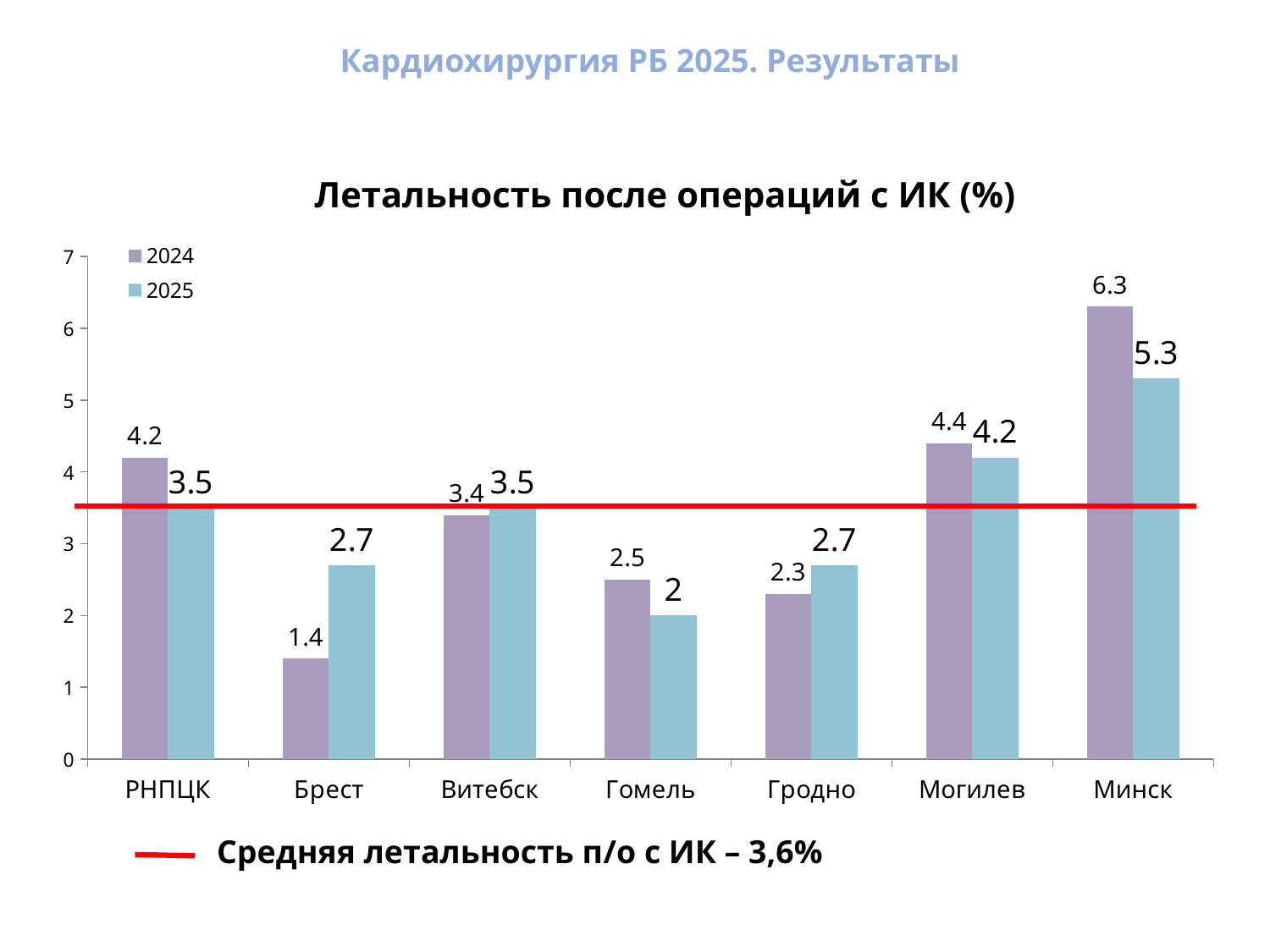
How many series does the legend list? 2 What is the title of the chart? Летальность после операций с ИК (%) Which category has the highest 2024 value? Минск Which category has the lowest 2025 value? Гомель Which is larger for Гродно, the 2024 value or the 2025 value? 2025 What kind of chart is shown on the slide? bar chart What is the 2024 value for Минск? 6.3 How many categories are shown on the x axis? 7 What is the 2025 value for Гомель? 2 Which category has the lowest 2024 value? Брест What is the 2025 value for Брест? 2.7 What is the difference between the 2024 and 2025 values for Минск? 1